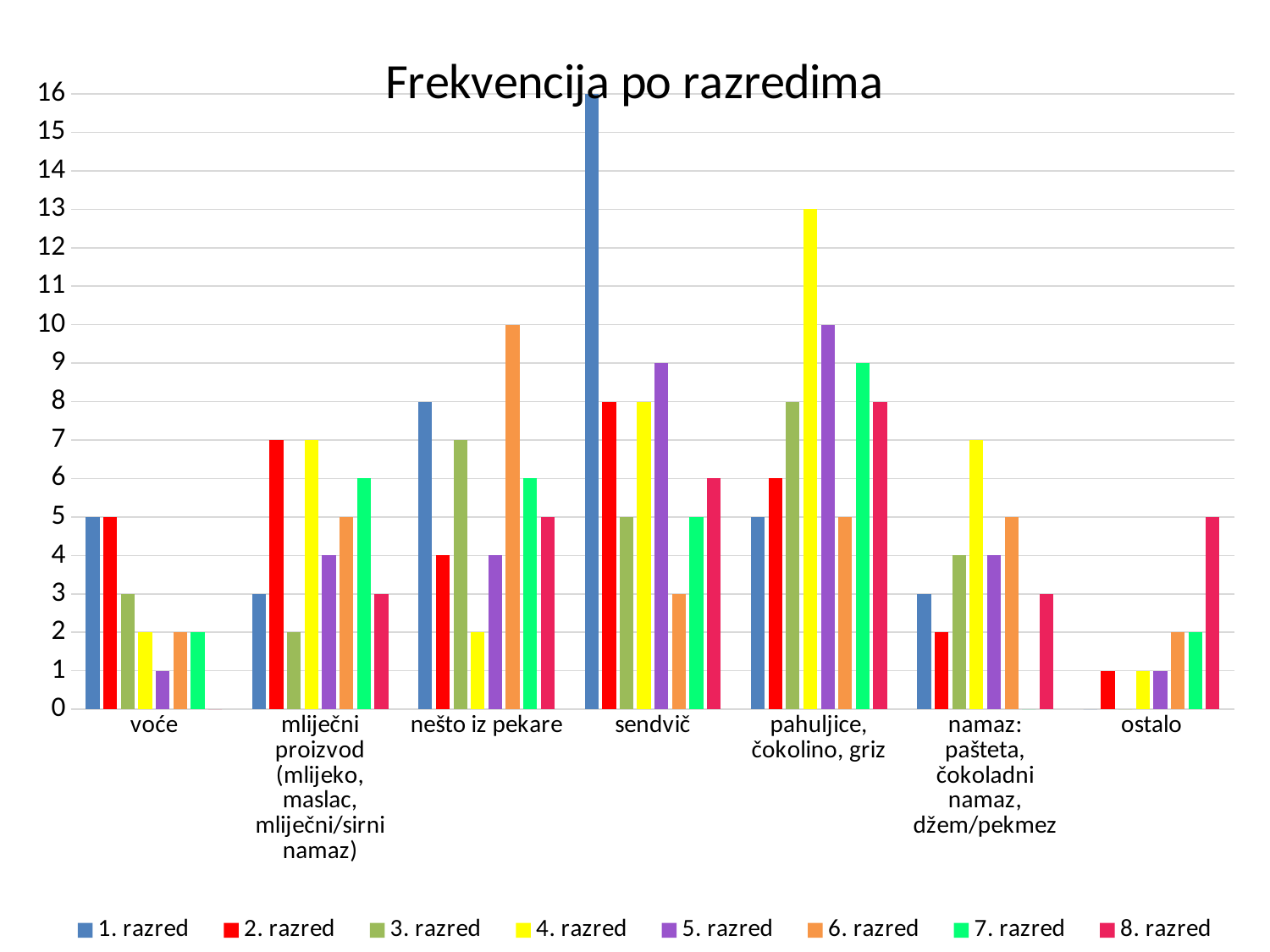
Which series has the highest value in the ostalo category? 8. razred What is the title of the chart? Frekvencija po razredima Is the value for 5. razred in the pahuljice, čokolino, griz category greater or less than 8? greater In which category does 1. razred have its highest value? sendvič What is the value for 1. razred in the sendvič category? 16 How many food categories are shown on the x axis? 7 What kind of chart is shown on the slide? bar chart What is the value for 4. razred in the pahuljice, čokolino, griz category? 13 What is the difference between the 1. razred and 2. razred values in the sendvič category? 8 How many series does the legend list? 8 In the mliječni proizvod category, which is larger: the value for 2. razred or the value for 3. razred? 2. razred What is the value for 6. razred in the nešto iz pekare category? 10